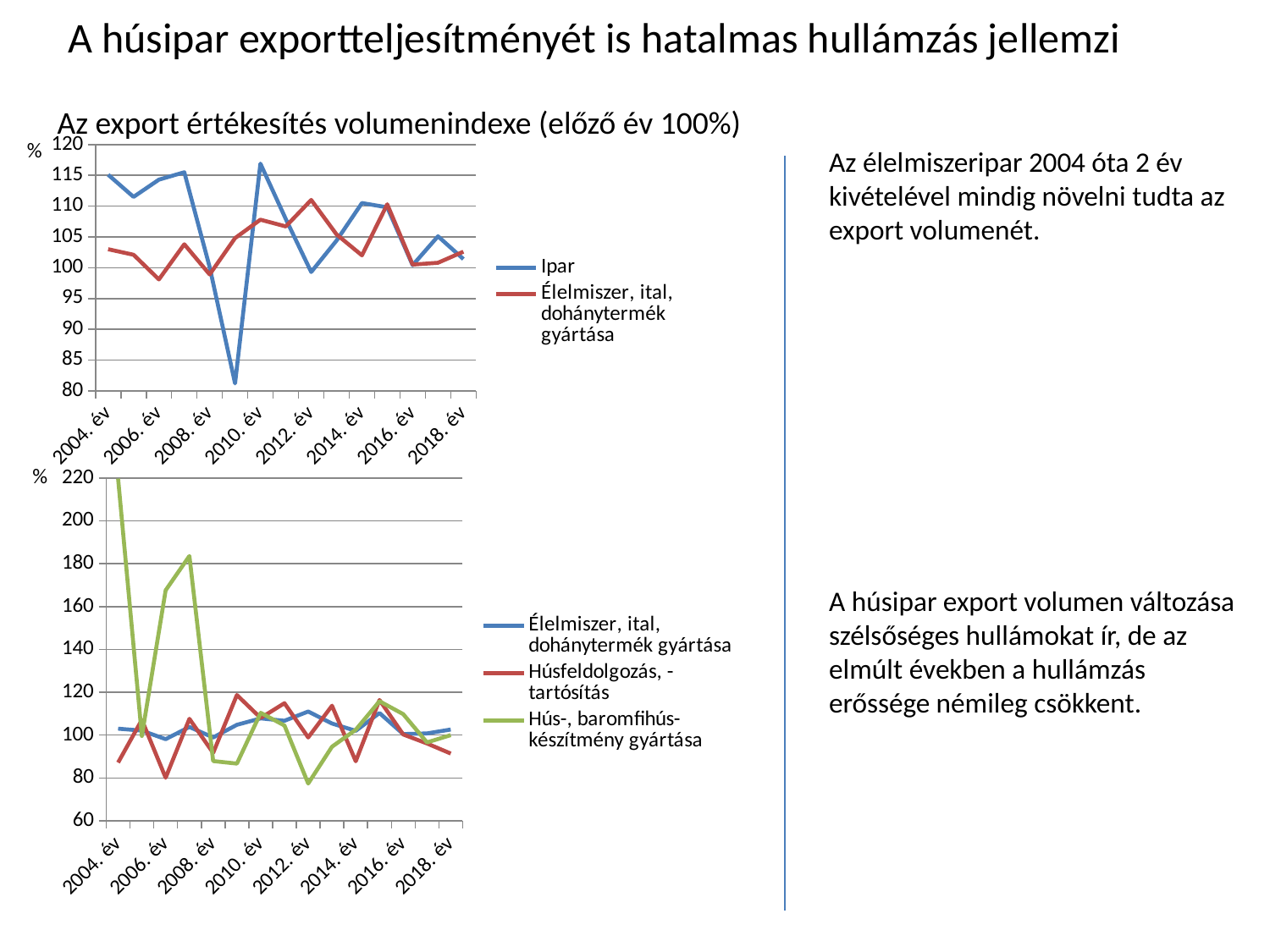
In the bottom chart, is the value for Húsfeldolgozás, -tartósítás in 2006. év greater or less than 100? less How many series does the legend of the bottom chart list? 3 In the top chart, is the value for Ipar in 2004. év greater or less than 110? greater In the bottom chart, is the value for Hús-, baromfihús-készítmény gyártása in 2004. év greater or less than 200? greater In the top chart, in which year does the Ipar series reach its lowest value? 2009. év What kind of chart is the top chart on the slide? line chart What is the title shown above the top chart? Az export értékesítés volumenindexe (előző év 100%) In the bottom chart, which series has the higher value in 2007. év, Hús-, baromfihús-készítmény gyártása or Élelmiszer, ital, dohánytermék gyártása? Hús-, baromfihús-készítmény gyártása How many series does the legend of the top chart list? 2 In the top chart, which series has the higher value in 2009. év, Ipar or Élelmiszer, ital, dohánytermék gyártása? Élelmiszer, ital, dohánytermék gyártása In the bottom chart, in which year does the Hús-, baromfihús-készítmény gyártása series reach its highest value? 2004. év